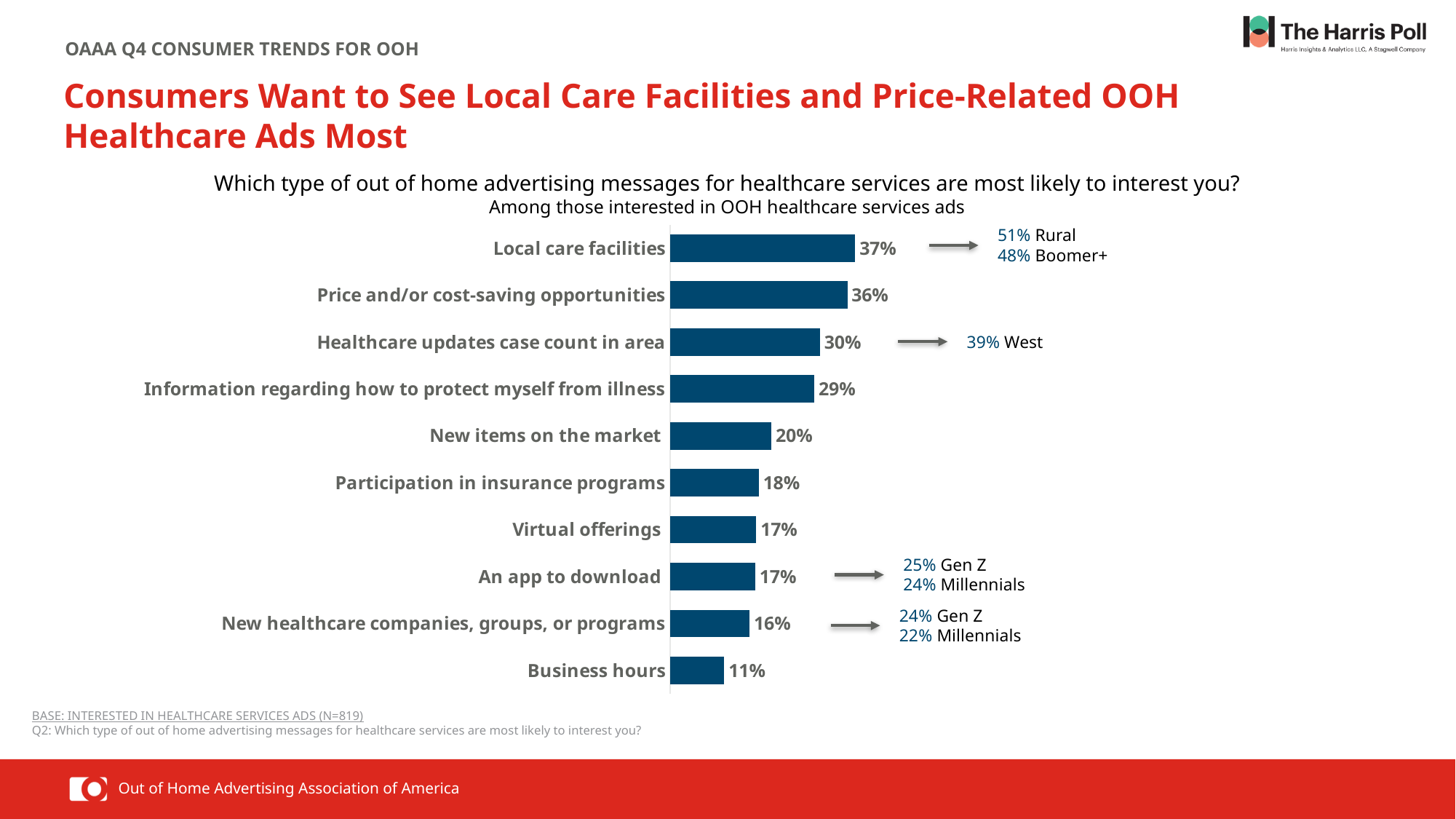
Which type of healthcare advertising message has the highest percentage? Local care facilities What is the value for 'Price and/or cost-saving opportunities'? 36% How many types of healthcare advertising messages are shown in the chart? 10 What is the difference in percentage points between 'Local care facilities' and 'Business hours'? 26 What is the difference in percentage points between 'Healthcare updates case count in area' and 'Participation in insurance programs'? 12 What is the value for 'New items on the market'? 20% Which type of healthcare advertising message has the lowest percentage? Business hours Which has a higher value: 'New items on the market' or 'Virtual offerings'? New items on the market What percentage is shown for 'Business hours'? 11% What kind of chart is used on this slide? Bar chart What percentage of respondents are interested in OOH healthcare ads about local care facilities? 37% According to the callout, what percentage of Rural respondents are interested in ads about local care facilities? 51%